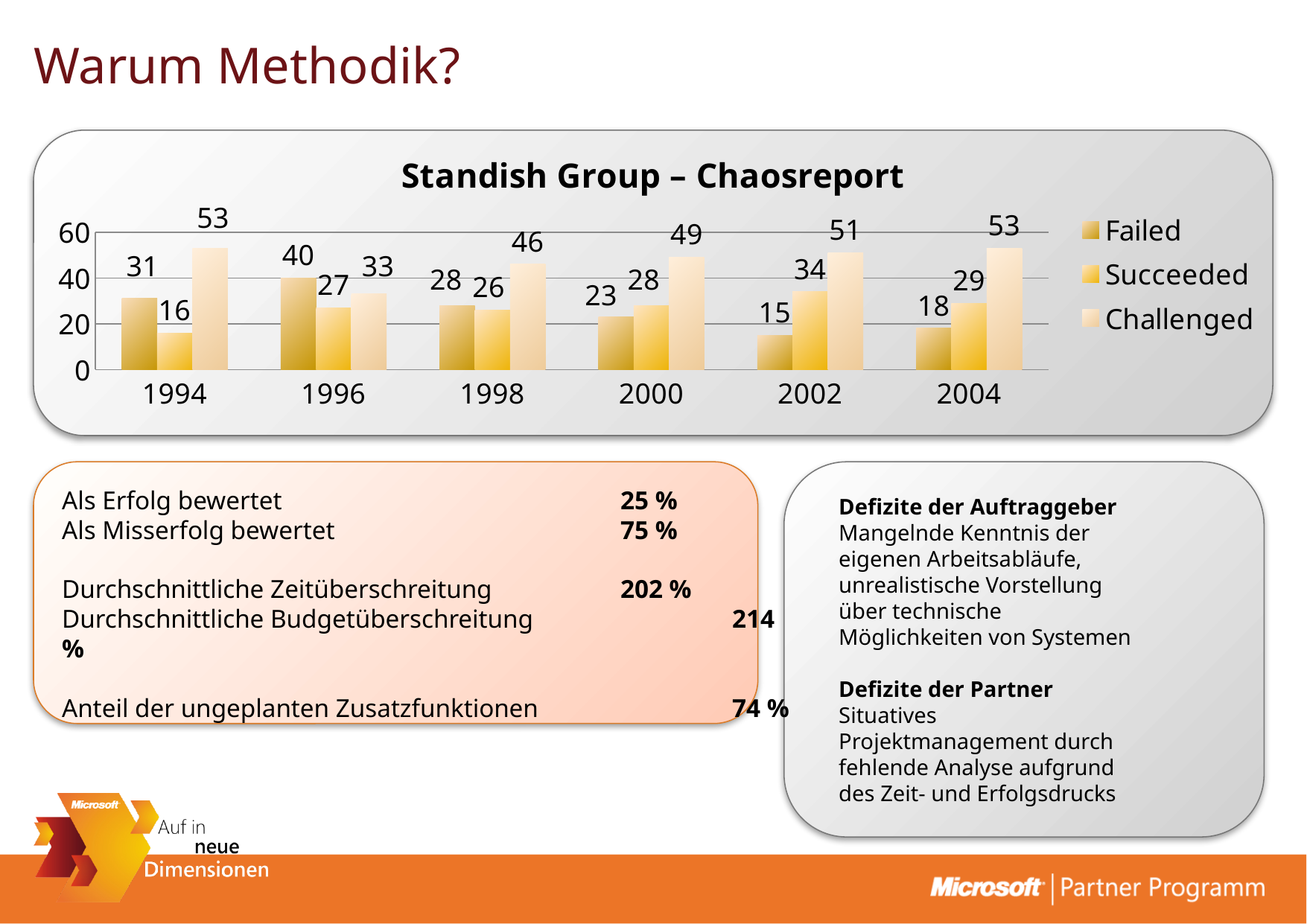
What is the title of the chart? Standish Group – Chaosreport What kind of chart is shown? Bar chart How many years are shown on the x axis? 6 Which year has the lowest Succeeded value? 1994 Which is larger in 1998, the Failed value or the Succeeded value? Failed What is the Challenged value for 2000? 49 What is the difference between the Challenged value in 1994 and in 1996? 20 What is the Failed value for 1996? 40 Which year has the highest Failed value? 1996 How many series does the legend list? 3 Does the Failed value rise or fall from 1996 to 2002? Fall What is the Succeeded value for 2002? 34